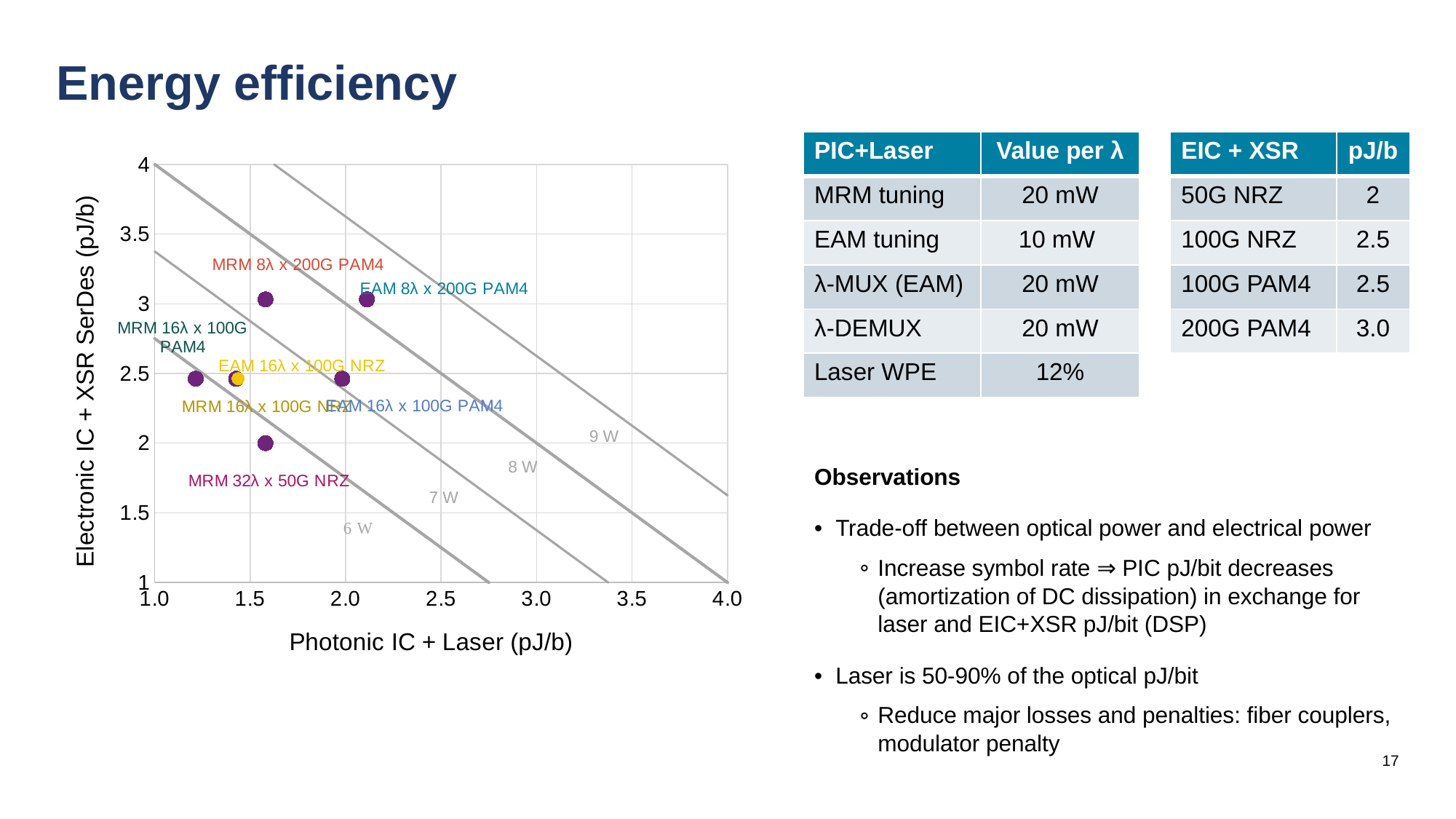
Which has the higher Electronic IC + XSR SerDes value, MRM 8λ x 200G PAM4 or MRM 32λ x 50G NRZ? MRM 8λ x 200G PAM4 Is the Photonic IC + Laser value for EAM 8λ x 200G PAM4 greater or less than 2.5? less Which labeled point has the lowest Photonic IC + Laser (pJ/b) value? MRM 16λ x 100G PAM4 What is the x-axis title of the chart? Photonic IC + Laser (pJ/b) Which has the higher Photonic IC + Laser value, EAM 16λ x 100G PAM4 or MRM 16λ x 100G PAM4? EAM 16λ x 100G PAM4 Is the Electronic IC + XSR SerDes value for MRM 32λ x 50G NRZ greater or less than 2.5? less Is the Photonic IC + Laser value for MRM 16λ x 100G PAM4 greater or less than 1.5? less What is the y-axis title of the chart? Electronic IC + XSR SerDes (pJ/b) What kind of chart is shown on the slide? scatter chart Which labeled point has the lowest Electronic IC + XSR SerDes (pJ/b) value? MRM 32λ x 50G NRZ Which labeled point has the highest Photonic IC + Laser (pJ/b) value? EAM 8λ x 200G PAM4